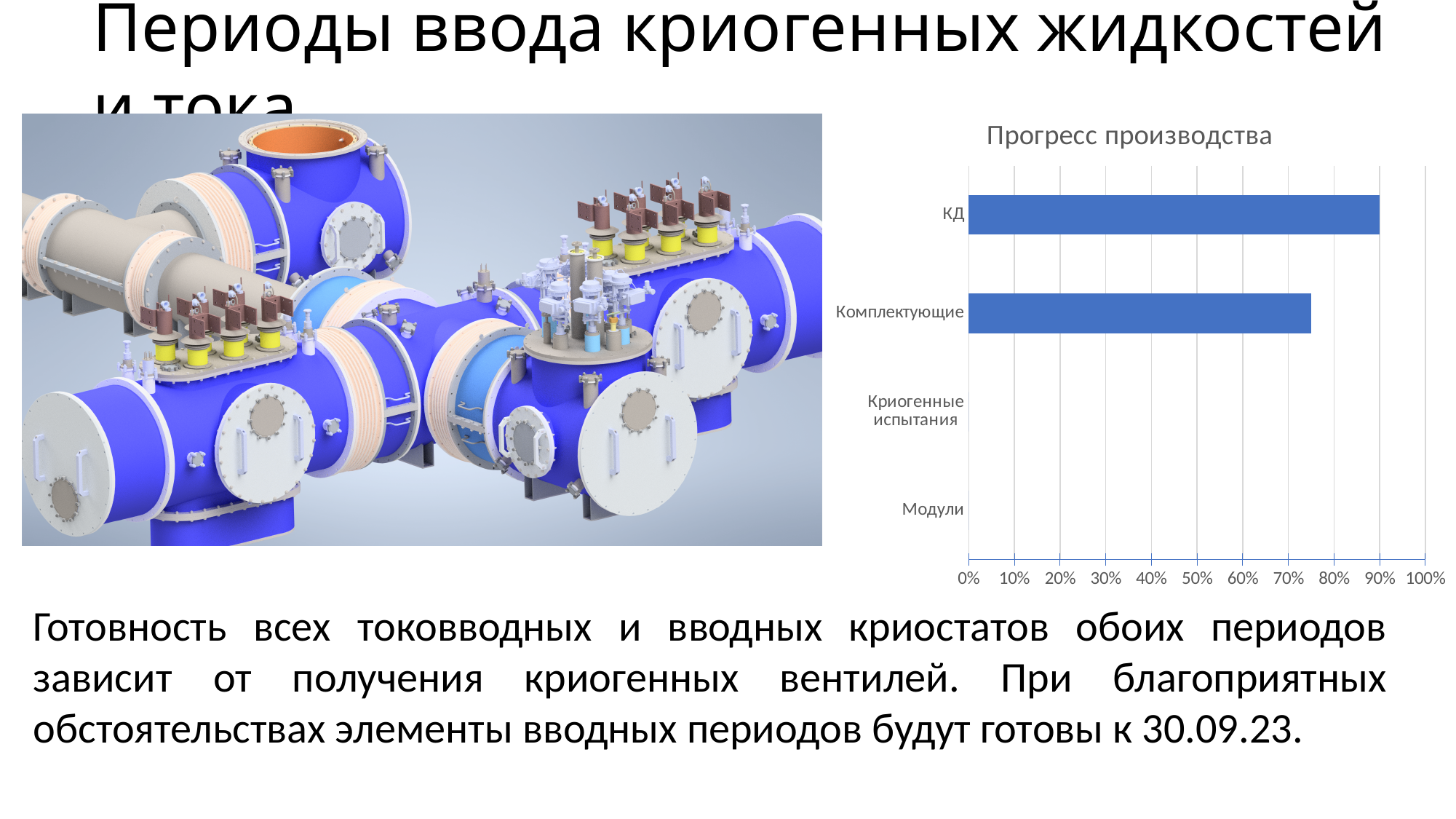
In the "Прогресс производства" chart, is the value for Комплектующие greater or less than 80%? less How many categories are listed on the vertical axis of the "Прогресс производства" chart? 4 What is the title of the chart on the slide? Прогресс производства In the "Прогресс производства" chart, is the value for КД greater or less than 80%? greater What kind of chart is shown under the title "Прогресс производства"? bar chart What is the maximum value shown on the horizontal axis of the "Прогресс производства" chart? 100% In the "Прогресс производства" chart, is the value for Комплектующие greater or less than 70%? greater In the "Прогресс производства" chart, what is the value for КД? 90% In the "Прогресс производства" chart, which categories have no visible bar? Криогенные испытания and Модули In the "Прогресс производства" chart, which is larger: the value for КД or the value for Комплектующие? КД In the "Прогресс производства" chart, which category has the highest value? КД